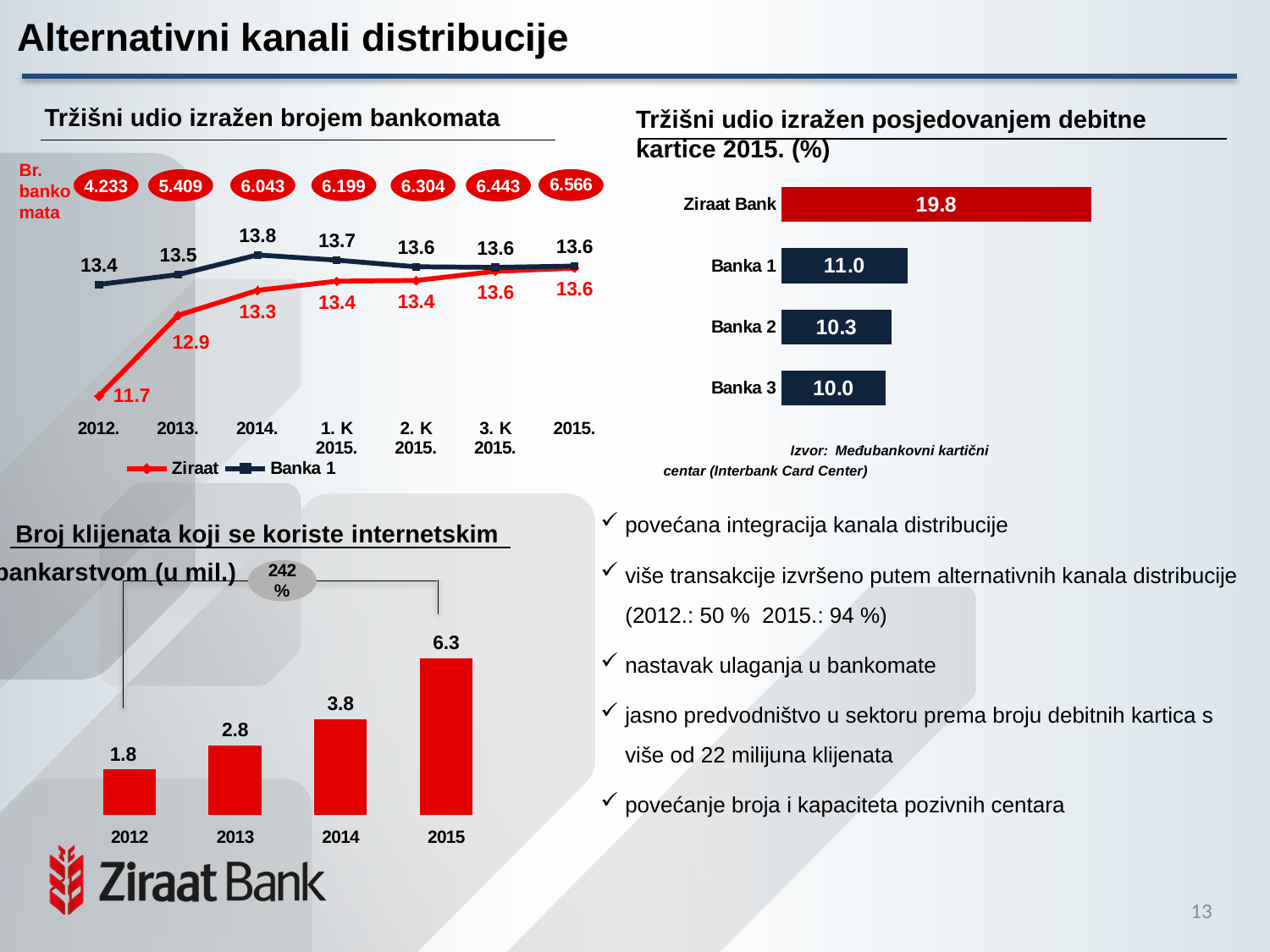
In the chart 'Tržišni udio izražen posjedovanjem debitne kartice 2015. (%)', what is the difference between Ziraat Bank and Banka 1? 8.8 What kind of chart is 'Tržišni udio izražen posjedovanjem debitne kartice 2015. (%)'? bar chart In the chart 'Tržišni udio izražen brojem bankomata', what is the value for Ziraat in 2012.? 11.7 In the chart 'Tržišni udio izražen brojem bankomata', does the Ziraat series rise or fall from 2012. to 2015.? rise In the chart 'Tržišni udio izražen brojem bankomata', what is the difference between Banka 1 and Ziraat in 2013.? 0.6 In the chart 'Broj klijenata koji se koriste internetskim bankarstvom (u mil.)', what is the value for 2015? 6.3 In the chart 'Tržišni udio izražen brojem bankomata', how many series does the legend list? 2 In the chart 'Tržišni udio izražen brojem bankomata', what is the value for Banka 1 in 2014.? 13.8 In the chart 'Tržišni udio izražen posjedovanjem debitne kartice 2015. (%)', what is the value for Banka 2? 10.3 In the chart 'Tržišni udio izražen posjedovanjem debitne kartice 2015. (%)', which bank has the highest value? Ziraat Bank In the chart 'Broj klijenata koji se koriste internetskim bankarstvom (u mil.)', how many years are shown? 4 In the chart 'Tržišni udio izražen brojem bankomata', what is the number of ATMs (Br. bankomata) shown for 2015.? 6.566